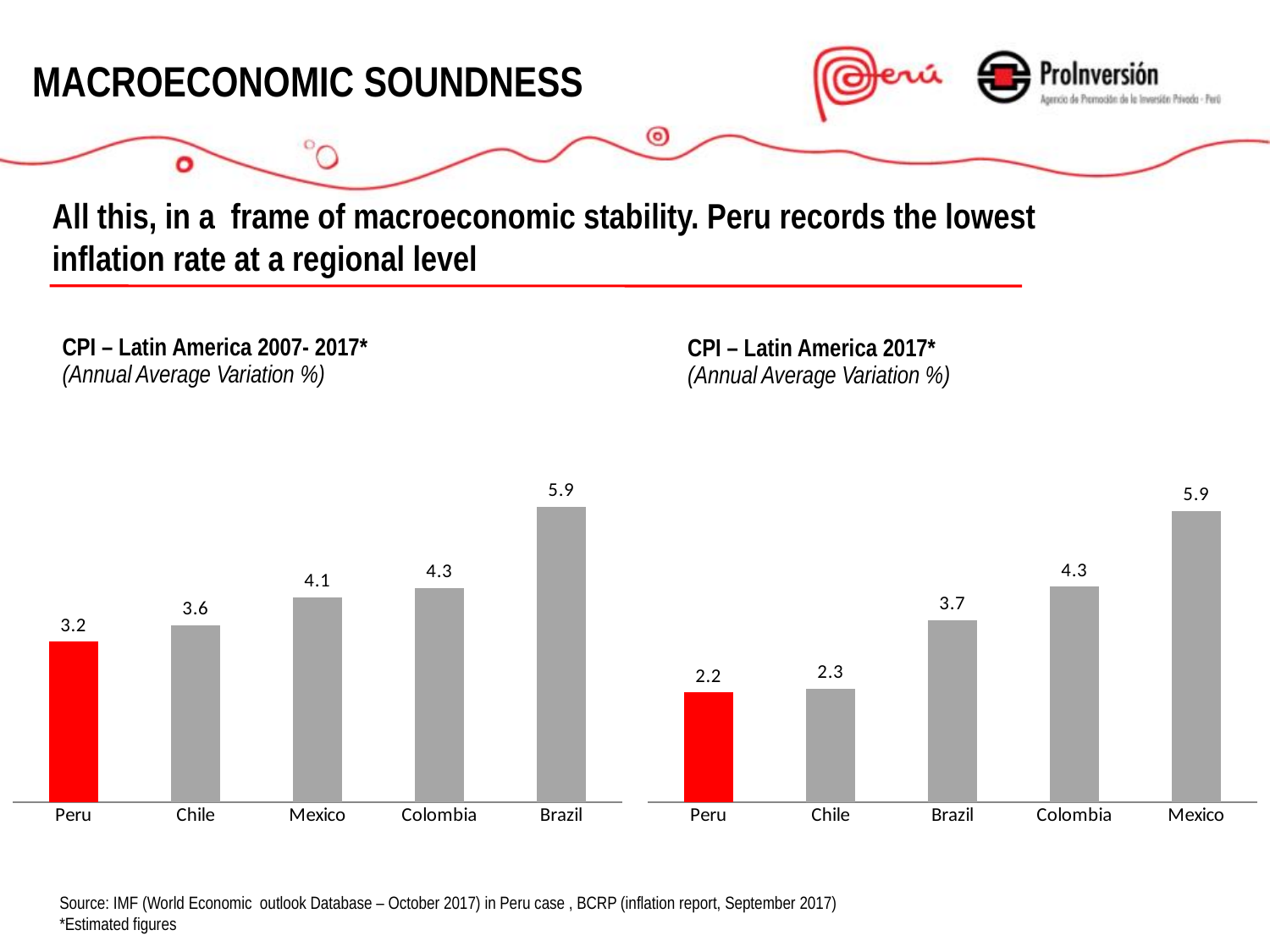
In the 'CPI – Latin America 2017*' chart, which country has the lowest value? Peru In the 'CPI – Latin America 2007-2017*' chart, what is the value for Peru? 3.2 What kind of chart is the 'CPI – Latin America 2007-2017*' chart? Bar chart In the 'CPI – Latin America 2017*' chart, which country has the highest value? Mexico In the 'CPI – Latin America 2007-2017*' chart, which country has the highest value? Brazil In the 'CPI – Latin America 2007-2017*' chart, what is the difference between the values for Brazil and Peru? 2.7 In the 'CPI – Latin America 2007-2017*' chart, which is larger, the value for Mexico or the value for Colombia? Colombia In the 'CPI – Latin America 2017*' chart, what is the difference between the values for Colombia and Chile? 2.0 In the 'CPI – Latin America 2017*' chart, what is the value for Brazil? 3.7 In the 'CPI – Latin America 2017*' chart, do the values rise or fall from left to right? Rise How many countries are shown in the 'CPI – Latin America 2017*' chart? 5 In the 'CPI – Latin America 2007-2017*' chart, which country's bar is coloured red? Peru